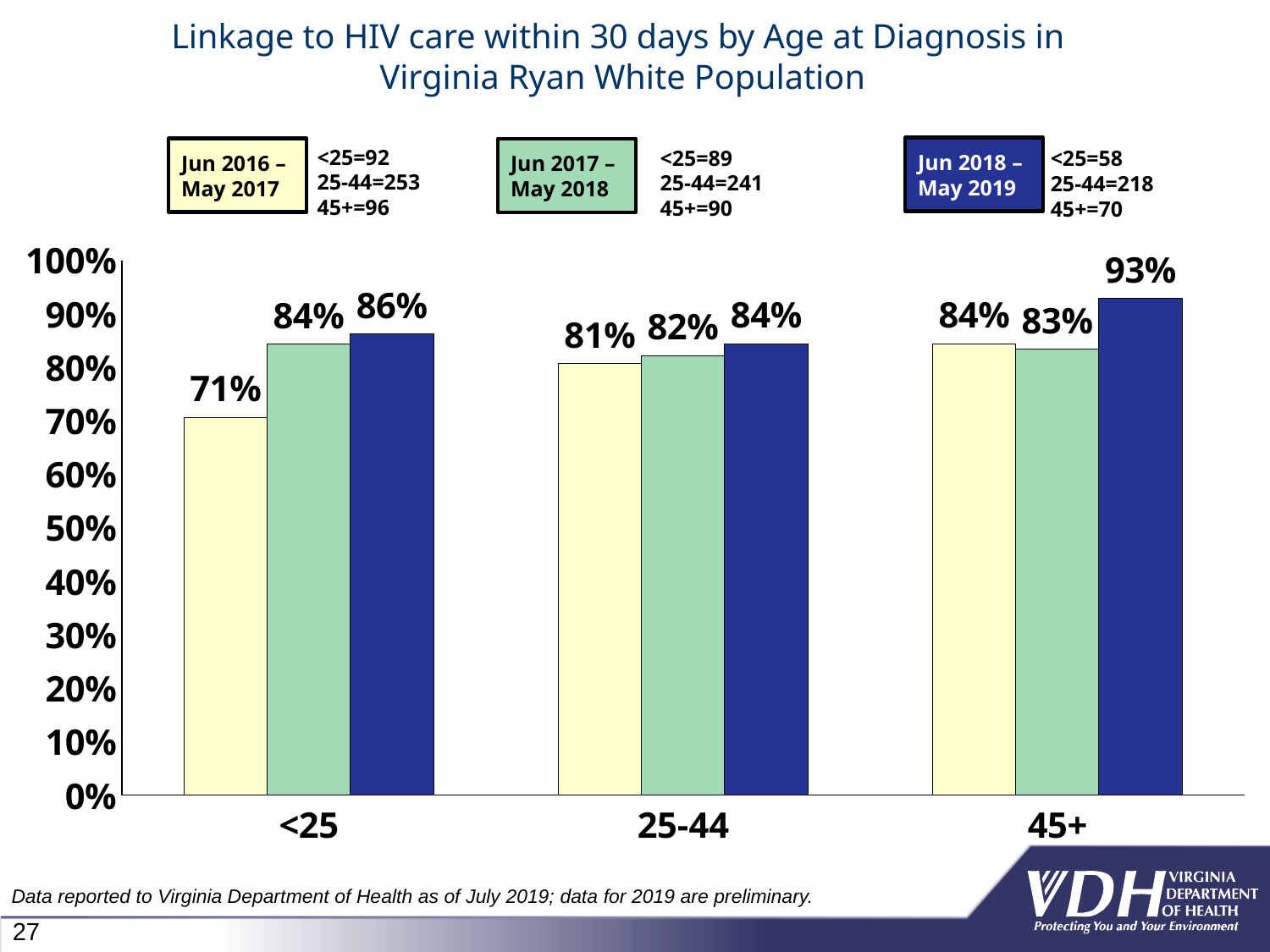
What is the value for the 45+ age group in Jun 2018 – May 2019? 93% For the 25-44 age group, do the values rise or fall from Jun 2016 – May 2017 to Jun 2018 – May 2019? Rise What kind of chart is shown on the slide? Bar chart How many age groups are shown on the x axis? 3 What is the linkage to HIV care within 30 days for the <25 age group in Jun 2016 – May 2017? 71% Which age group has the lowest value in Jun 2016 – May 2017? <25 What is the difference between the Jun 2018 – May 2019 and Jun 2016 – May 2017 values for the <25 age group? 15% What is the value for the 25-44 age group in Jun 2017 – May 2018? 82% For the 45+ age group, which is larger: the Jun 2016 – May 2017 value or the Jun 2017 – May 2018 value? Jun 2016 – May 2017 How many time periods (series) does the legend list? 3 Which colour represents the Jun 2018 – May 2019 period? Dark blue Which age group has the highest value in Jun 2018 – May 2019? 45+